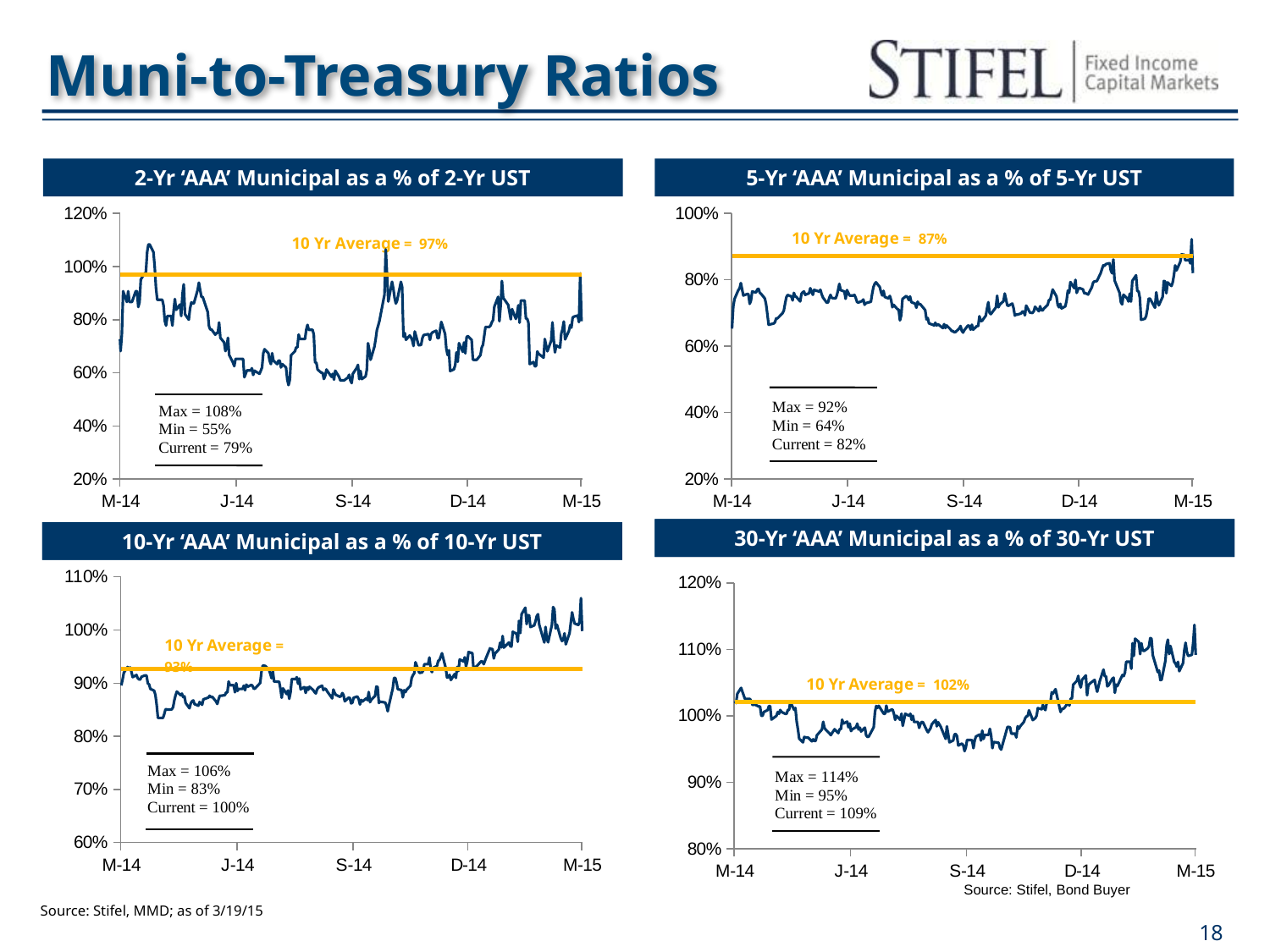
In the '30-Yr ‘AAA’ Municipal as a % of 30-Yr UST' chart, is the Current value larger or smaller than the 10 Yr Average? larger What kind of chart is the '2-Yr ‘AAA’ Municipal as a % of 2-Yr UST' chart? line chart In the '5-Yr ‘AAA’ Municipal as a % of 5-Yr UST' chart, what is the Current value? 82% In the '5-Yr ‘AAA’ Municipal as a % of 5-Yr UST' chart, what is the difference between the Max and Min values? 28% In the '30-Yr ‘AAA’ Municipal as a % of 30-Yr UST' chart, does the line generally rise or fall from S-14 to M-15? rise Which of the four charts has the highest Max value in its text box? 30-Yr ‘AAA’ Municipal as a % of 30-Yr UST How many charts are shown on the slide? 4 In the '2-Yr ‘AAA’ Municipal as a % of 2-Yr UST' chart, what is the Max value shown in the text box? 108% In the '10-Yr ‘AAA’ Municipal as a % of 10-Yr UST' chart, what is the Min value? 83% In the '2-Yr ‘AAA’ Municipal as a % of 2-Yr UST' chart, what is the 10 Yr Average? 97% In the '30-Yr ‘AAA’ Municipal as a % of 30-Yr UST' chart, what is the 10 Yr Average? 102% In the '2-Yr ‘AAA’ Municipal as a % of 2-Yr UST' chart, is the Current value greater or less than the 10 Yr Average? less